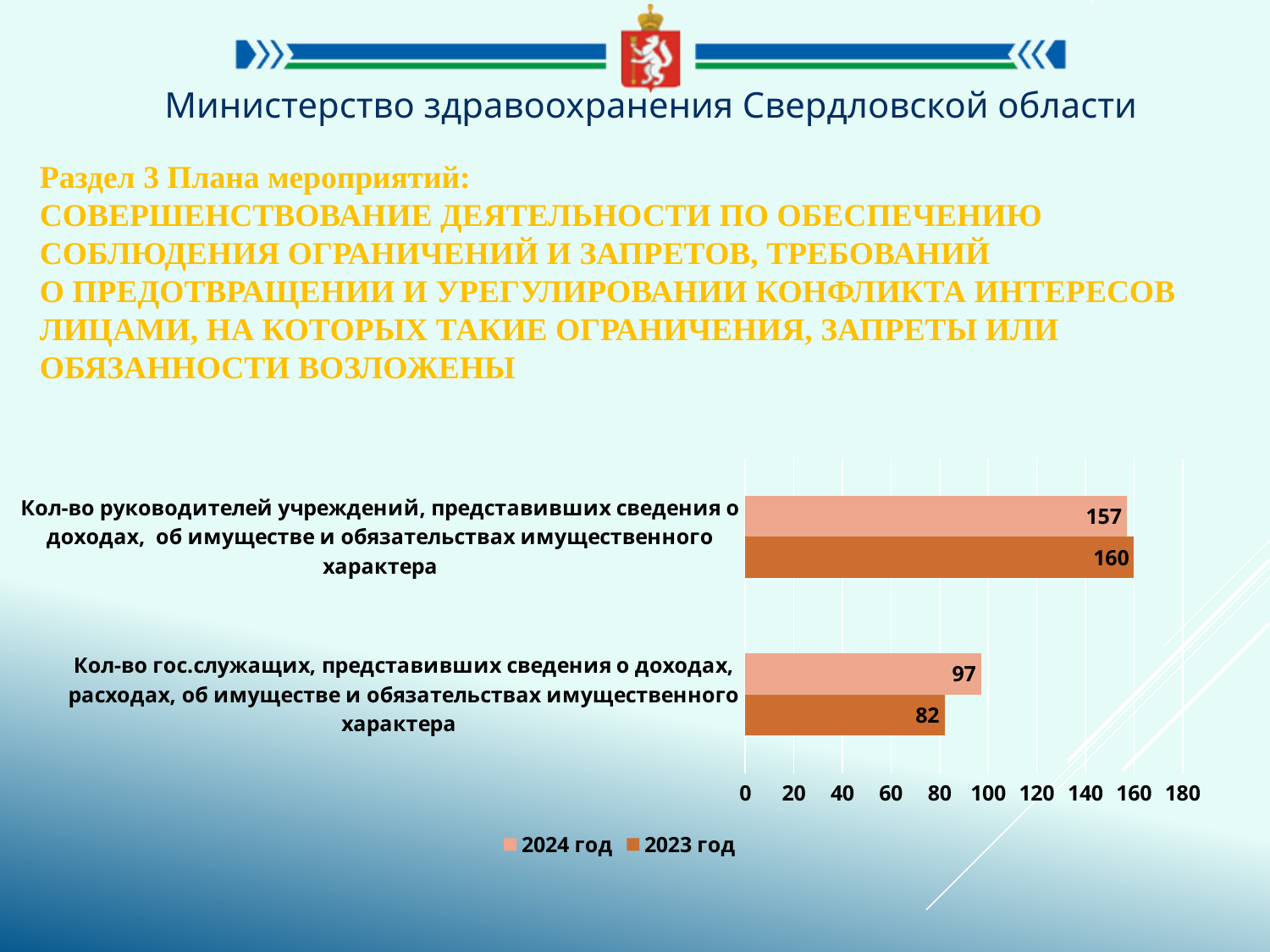
Какое значение показано для категории «Кол-во гос.служащих, представивших сведения о доходах, расходах, об имуществе и обязательствах имущественного характера» за 2024 год? 97 Какой столбец на диаграмме имеет наибольшее значение? Кол-во руководителей учреждений, 2023 год (160) Какое значение показано для категории «Кол-во руководителей учреждений, представивших сведения о доходах, об имуществе и обязательствах имущественного характера» за 2024 год? 157 Сколько категорий показано на диаграмме? 2 Какой тип диаграммы показан на слайде? Столбчатая (линейчатая) диаграмма Какое значение показано для категории «Кол-во руководителей учреждений, представивших сведения о доходах, об имуществе и обязательствах имущественного характера» за 2023 год? 160 Какое значение показано для категории «Кол-во гос.служащих, представивших сведения о доходах, расходах, об имуществе и обязательствах имущественного характера» за 2023 год? 82 Какой столбец на диаграмме имеет наименьшее значение? Кол-во гос.служащих, 2023 год (82) На сколько значение для гос.служащих за 2024 год больше значения за 2023 год? 15 Что больше: значение для гос.служащих за 2024 год или за 2023 год? 2024 год На сколько значение для руководителей учреждений за 2023 год больше значения за 2024 год? 3 Сколько рядов данных указано в легенде диаграммы? 2